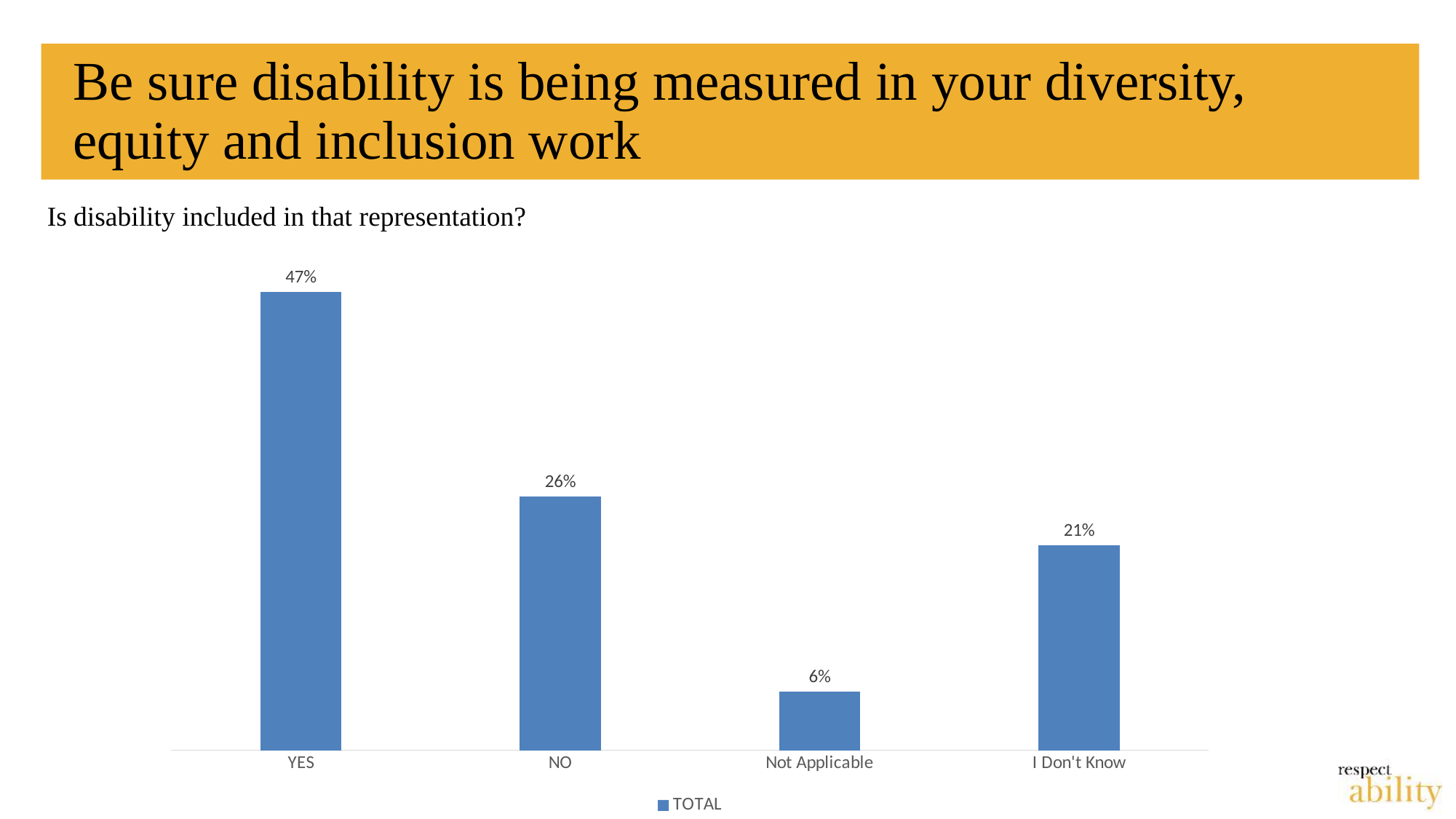
What is the value for Not Applicable? 6% What is the difference between the values for NO and I Don't Know? 5% How many categories are shown on the x axis? 4 What is the value for YES? 47% Which category has the lowest value? Not Applicable Which category has the highest value? YES What is the difference between the values for YES and NO? 21% Which is larger, the value for NO or the value for I Don't Know? NO What is the value for I Don't Know? 21% What is the value for NO? 26% What kind of chart is shown on the slide? Bar chart What series name does the legend list? TOTAL